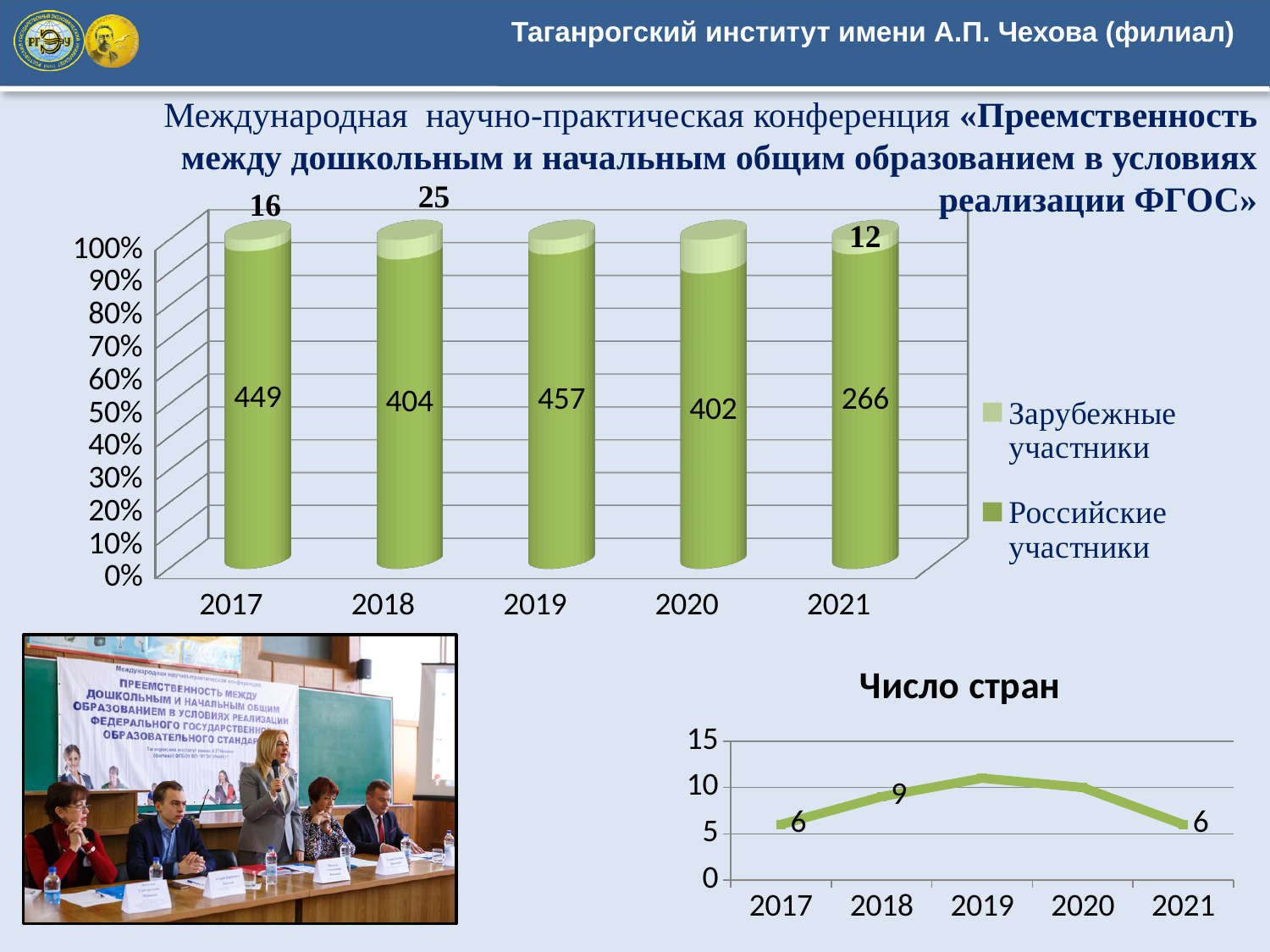
In the top stacked bar chart, which year has the lowest value for Российские участники? 2021 In the top stacked bar chart, what is the difference between the Российские участники values for 2017 and 2021? 183 How many years are shown on the x axis of the top stacked bar chart? 5 In the top stacked bar chart, what is the value for Российские участники in 2021? 266 In the top stacked bar chart, what is the value for Российские участники in 2019? 457 In the chart titled 'Число стран', what is the value for 2018? 9 In the top stacked bar chart, what is the value for Зарубежные участники in 2018? 25 In the chart titled 'Число стран', is the value for 2019 greater or less than 10? greater In the top stacked bar chart, which is larger: Российские участники in 2018 or in 2020? 2018 How many series does the legend of the top stacked bar chart list? 2 In the top stacked bar chart, which year has the highest value for Российские участники? 2019 What kind of chart is the chart titled 'Число стран'? line chart